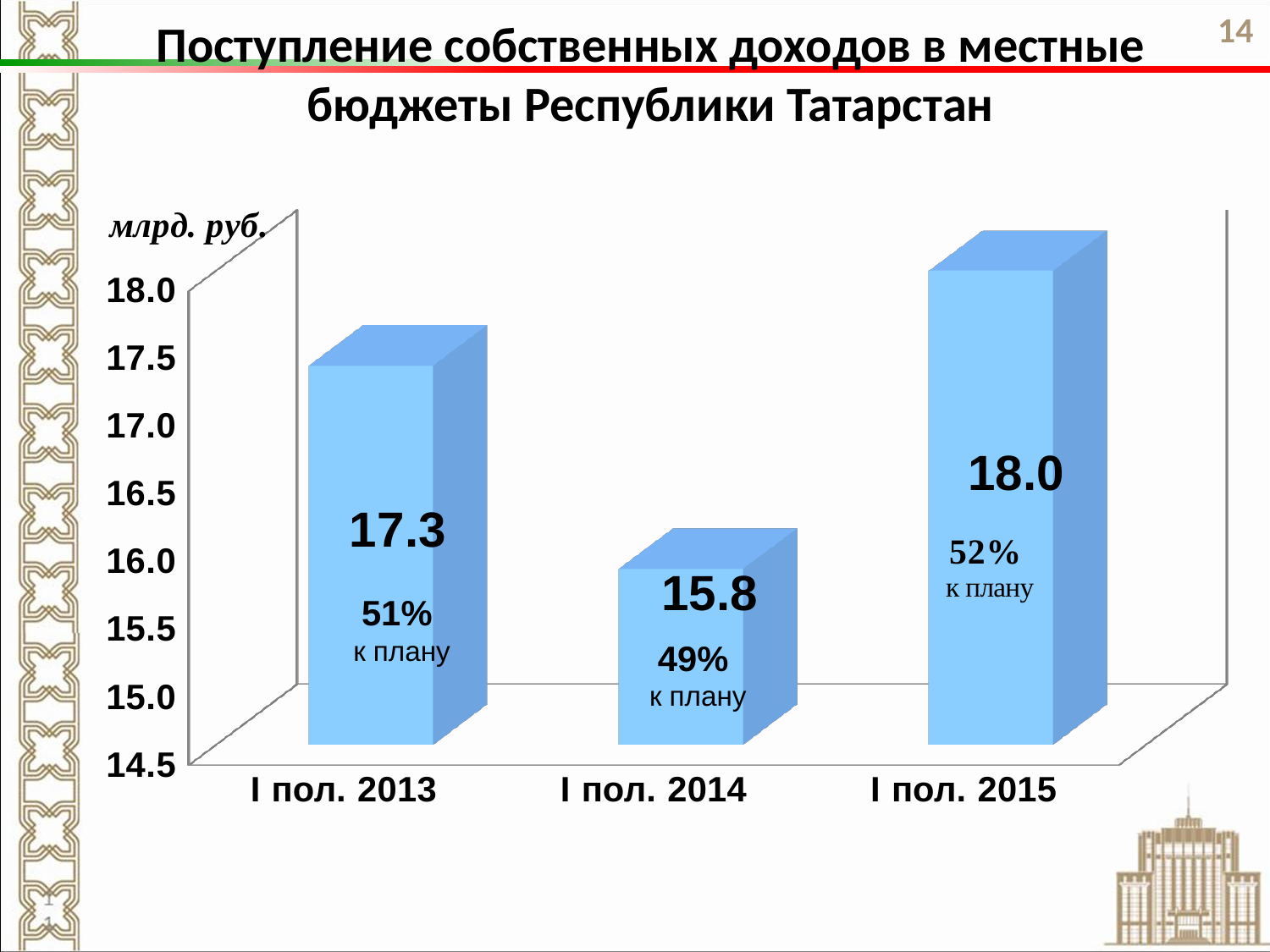
What is the value for I пол. 2015? 18.0 What percentage of the plan is shown for I пол. 2014? 49% Which period has the highest value? I пол. 2015 How many periods are shown in the chart? 3 Which is larger, the value for I пол. 2013 or I пол. 2015? I пол. 2015 What is the difference between the values for I пол. 2015 and I пол. 2014? 2.2 What kind of chart is shown on the slide? bar chart Which period has the lowest value? I пол. 2014 What unit is indicated for the values in the chart? млрд. руб. What is the value for I пол. 2013? 17.3 What is the difference between the values for I пол. 2013 and I пол. 2014? 1.5 What is the value for I пол. 2014? 15.8